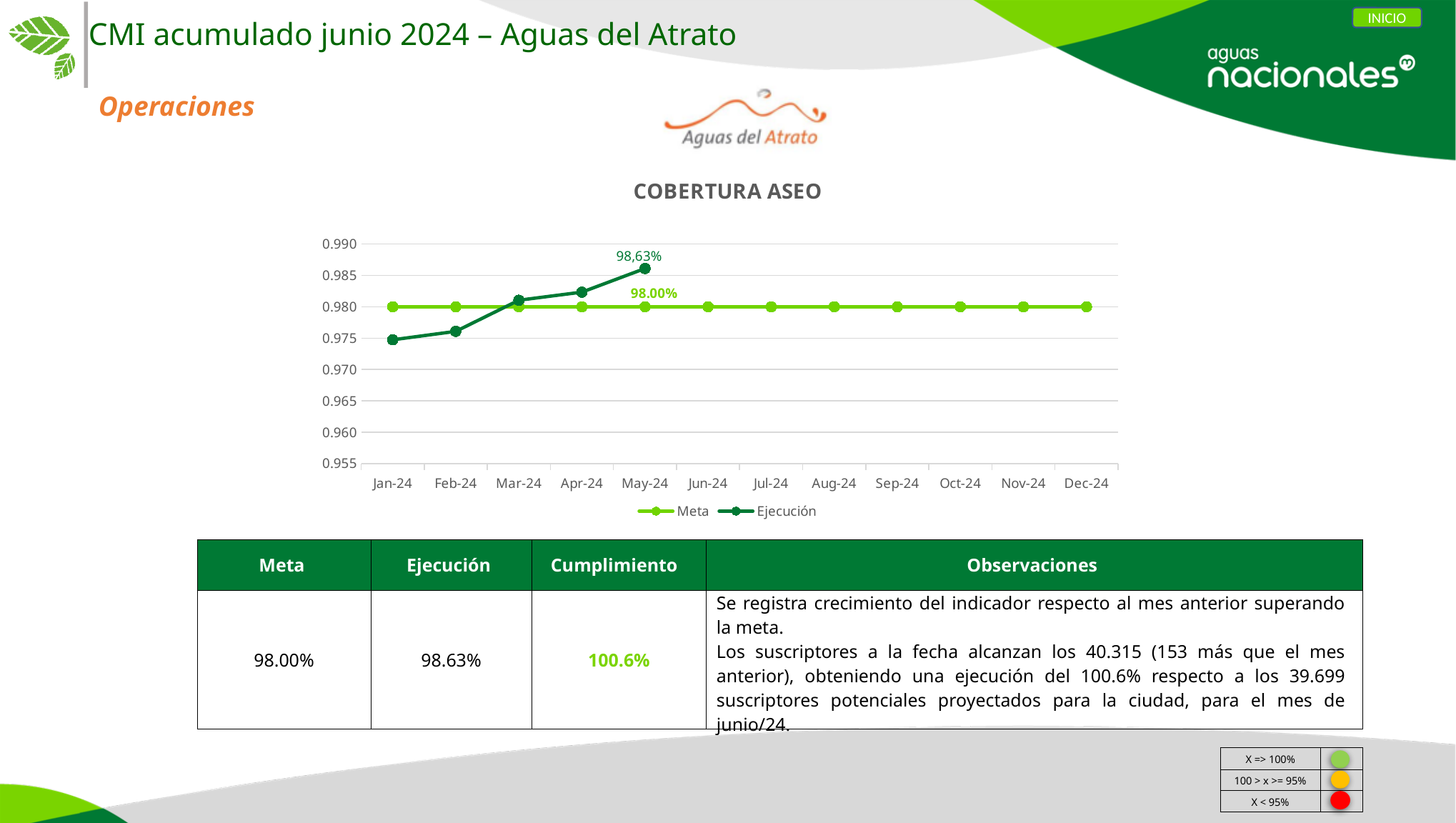
In which month does the Ejecución series have its lowest value? Jan-24 Does the Ejecución series rise or fall from Jan-24 to May-24? rise At May-24, which series has the larger value, Meta or Ejecución? Ejecución How many series does the legend of the COBERTURA ASEO chart list? 2 What kind of chart is shown under the title COBERTURA ASEO? line chart What is the labelled value of the Meta series? 98.00% How many months are shown on the x axis of the COBERTURA ASEO chart? 12 In which month does the Ejecución series reach its highest value? May-24 Is the Ejecución value for Feb-24 greater or less than 0.980? less What is the labelled value of the Ejecución series at May-24? 98,63% At Jan-24, which series has the larger value, Meta or Ejecución? Meta What are the two legend entries of the COBERTURA ASEO chart? Meta and Ejecución